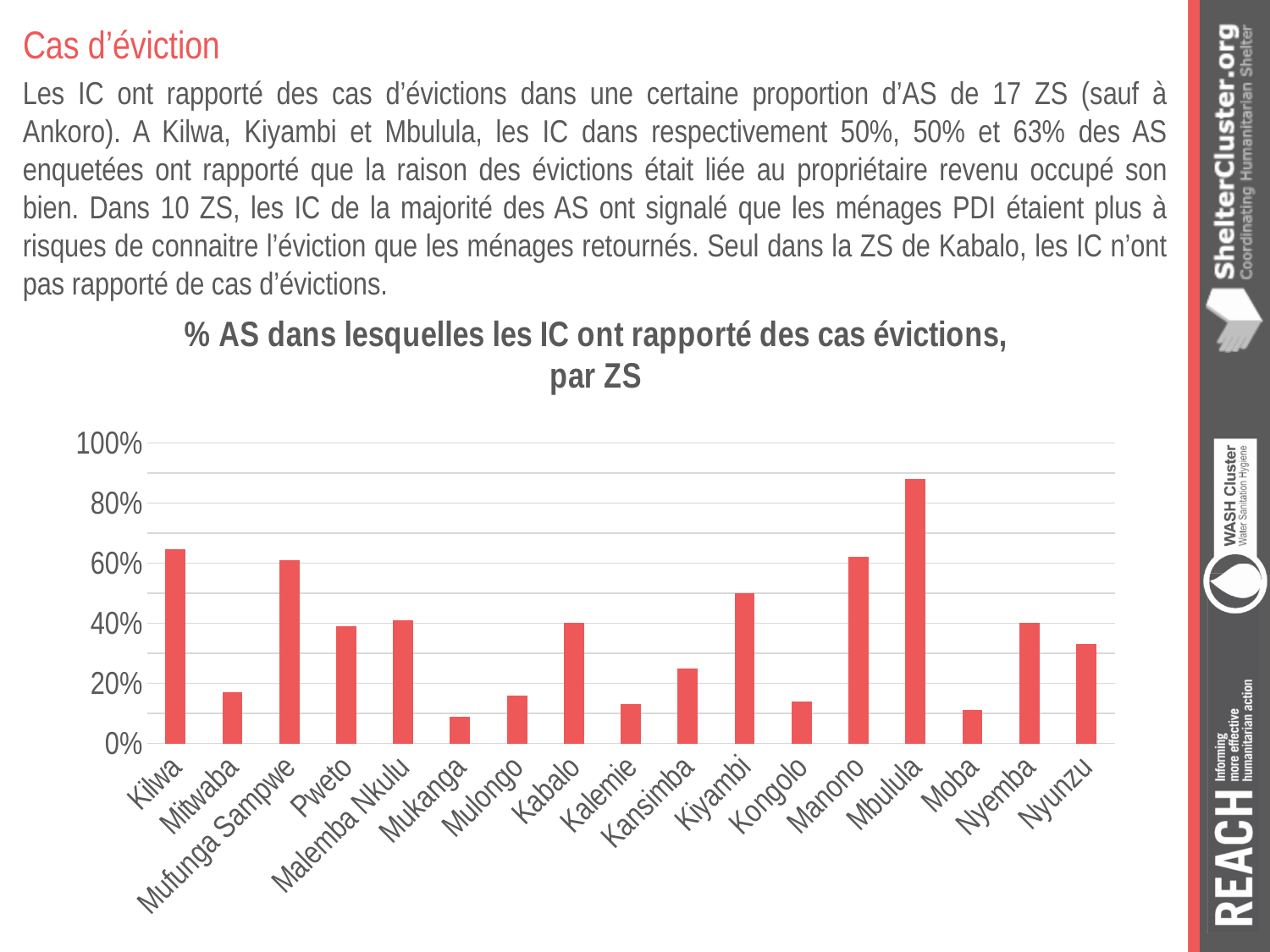
Which has a higher value, Kilwa or Mitwaba? Kilwa What is the title of the chart? % AS dans lesquelles les IC ont rapporté des cas évictions, par ZS Which ZS has the highest value in the chart? Mbulula Which has a higher value, Kiyambi or Kongolo? Kiyambi Is the value for Kilwa greater or less than 60%? greater Is the value for Mbulula greater or less than 80%? greater Is the value for Nyunzu greater or less than 40%? less How many ZS (categories) are shown on the x axis of the chart? 17 Which has a higher value, Mbulula or Manono? Mbulula What kind of chart is shown on the slide? bar chart